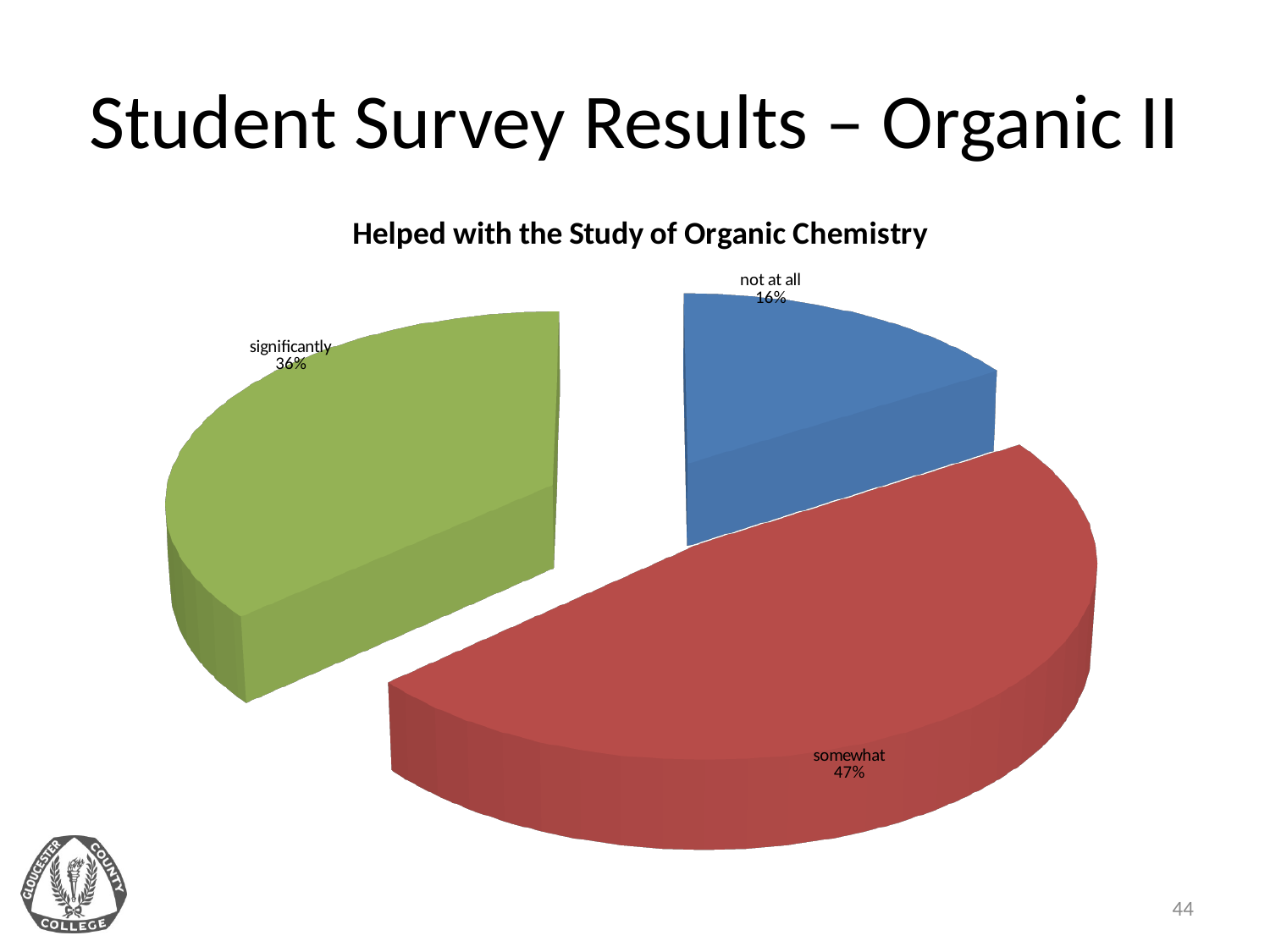
Which response category has the largest share of the pie? somewhat What colour is the "somewhat" slice? red What is the difference in percentage points between "significantly" and "not at all"? 20 Which response category has the smallest share of the pie? not at all What percentage of respondents answered "significantly"? 36% What percentage of respondents answered "not at all"? 16% What percentage of respondents answered "somewhat"? 47% What is the difference in percentage points between "somewhat" and "significantly"? 11 How many categories are shown in the pie chart? 3 Which is larger, the share for "significantly" or the share for "not at all"? significantly What is the title of the chart? Helped with the Study of Organic Chemistry What kind of chart is shown on the slide? pie chart